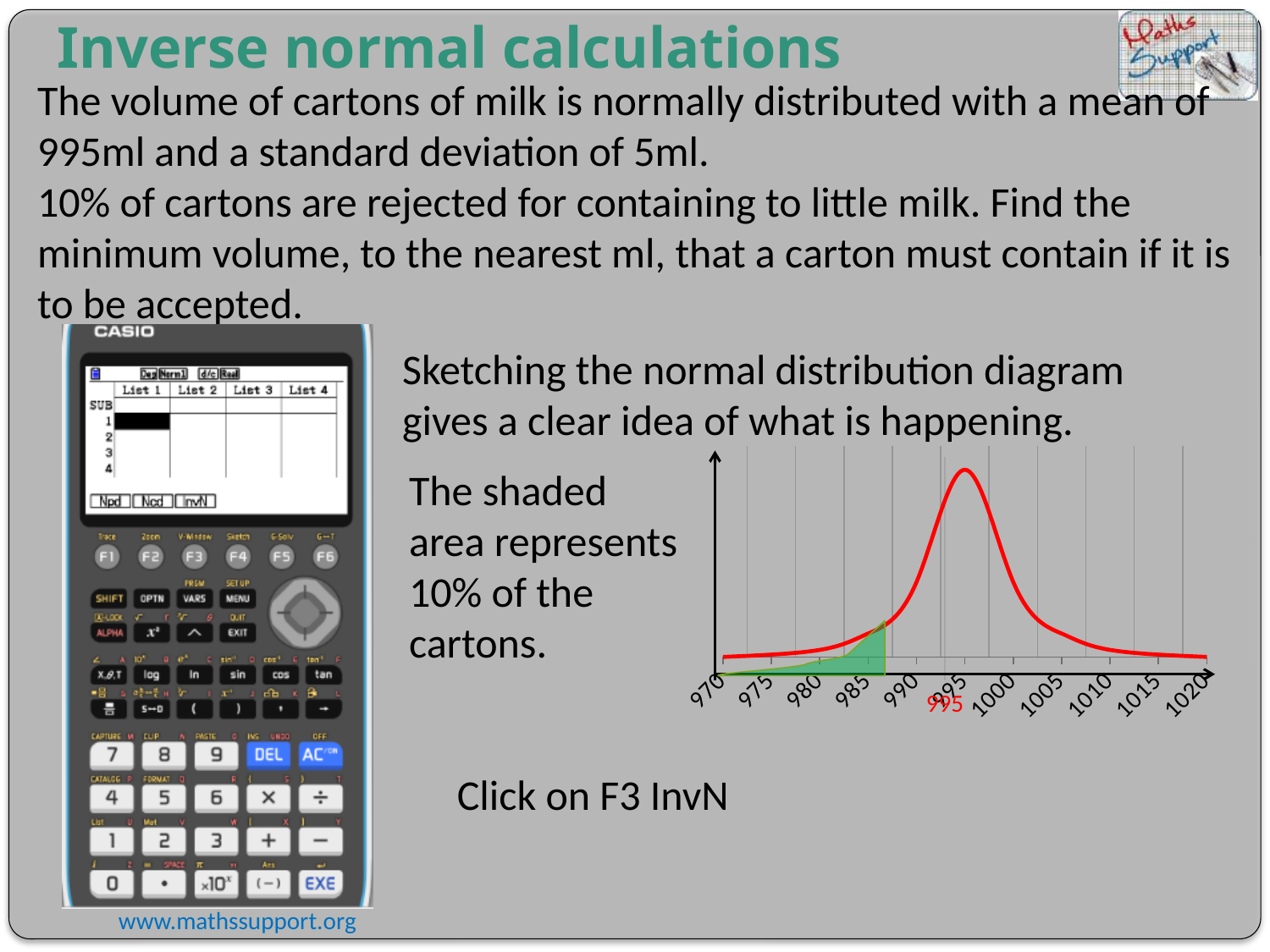
Does the red curve rise or fall as x increases from 970 to 995? rise What is the step between consecutive labelled tick values on the x axis? 5 Is the curve higher at 990 or at 1005? 990 What is the highest value labelled on the x axis of the diagram? 1020 What is the lowest value labelled on the x axis of the diagram? 970 At which x-axis value does the red curve reach its peak? 995 Does the red curve rise or fall as x increases from 995 to 1020? fall What kind of chart is the normal distribution diagram on the slide? line chart What percentage of cartons does the shaded area represent? 10% How many labelled tick values are shown on the x axis of the normal distribution diagram? 11 Is the curve higher at 980 or at 995? 995